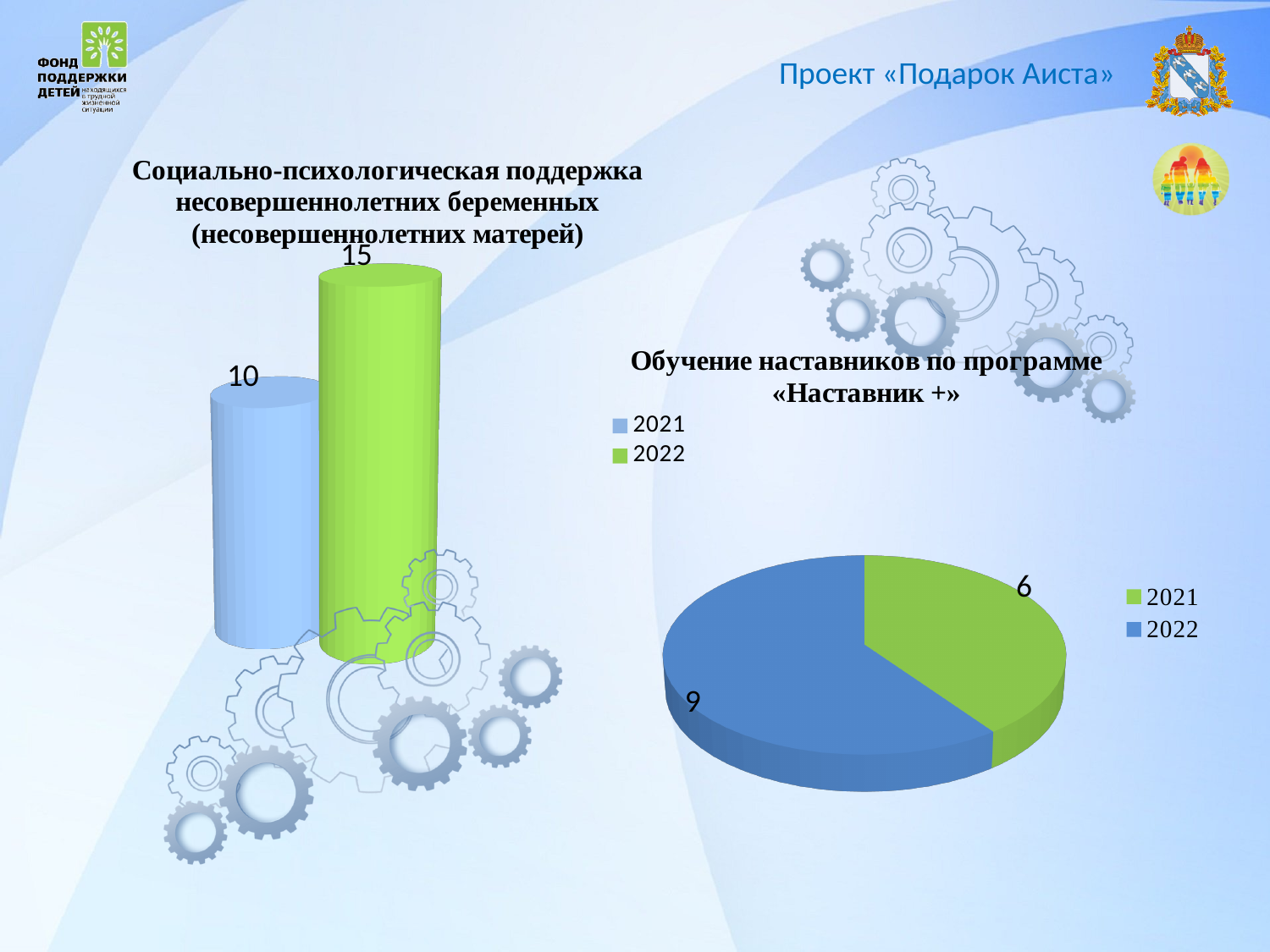
What kind of chart is the one on the left of the slide? bar chart In the bar chart titled «Социально-психологическая поддержка несовершеннолетних беременных», what is the value for 2022? 15 In the pie chart on the right, which year has the larger slice? 2022 In the pie chart on the right, what colour is the 2022 slice? blue In the pie chart on the right, what is the total of the two slices? 15 In the pie chart titled «Обучение наставников по программе «Наставник +»», what is the value for 2021? 6 In the bar chart on the left, what is the difference between the 2022 and 2021 values? 5 In the bar chart titled «Социально-психологическая поддержка несовершеннолетних беременных», what is the value for 2021? 10 In the pie chart titled «Обучение наставников по программе «Наставник +»», what is the value for 2022? 9 What kind of chart is the one on the right of the slide? pie chart How many series does the legend of the bar chart on the left list? 2 In the bar chart on the left, which year has the higher value? 2022